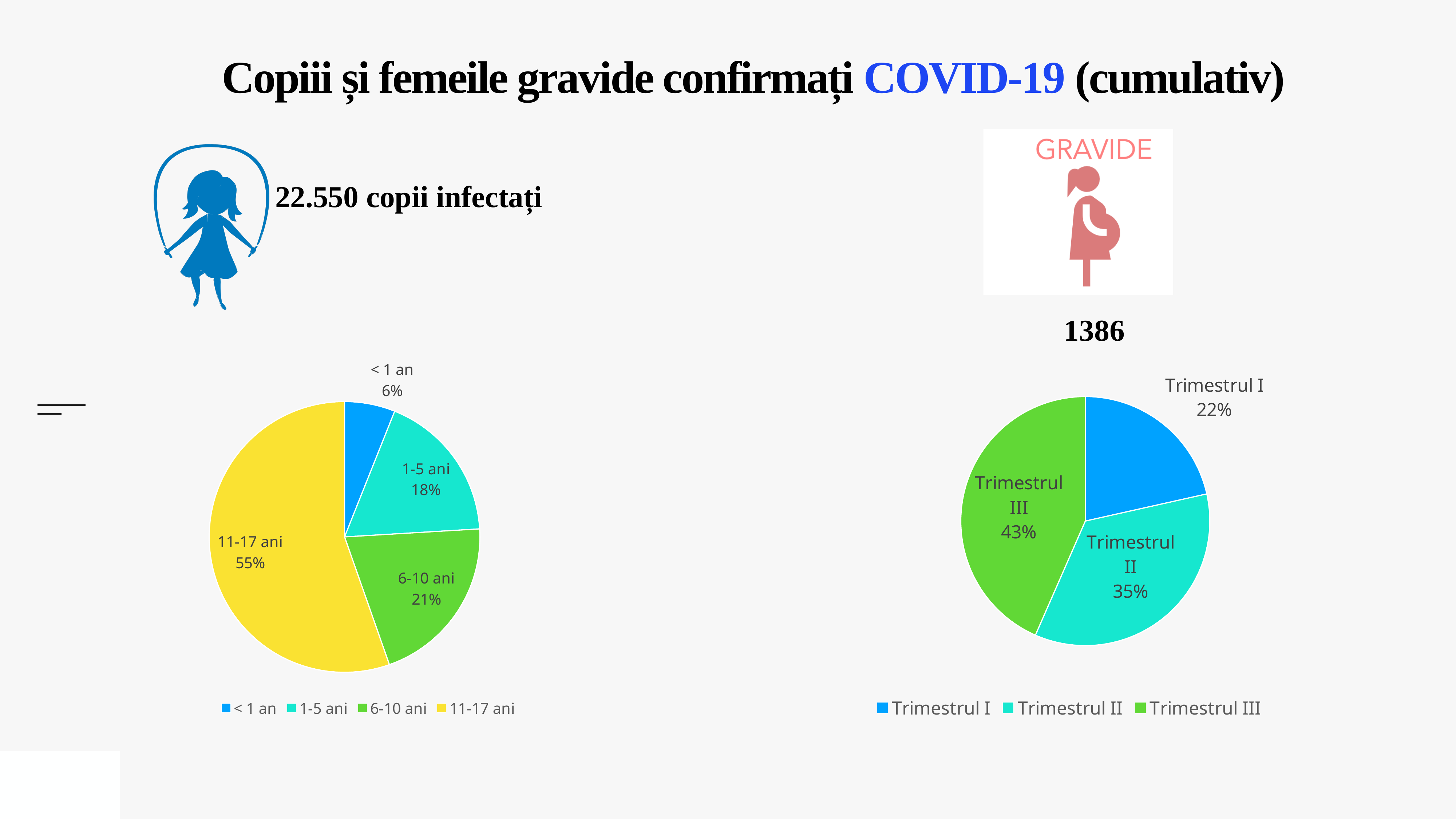
In the left pie chart (children by age group), which age group has the smallest slice? < 1 an In the left pie chart (children by age group), how many slices are there? 4 In the left pie chart (children by age group), what is the difference between the shares for 6-10 ani and 1-5 ani? 3% In the right pie chart (pregnant women by trimester), what share is labelled for Trimestrul II? 35% In the right pie chart (pregnant women by trimester), which is larger, Trimestrul I or Trimestrul II? Trimestrul II What kind of chart is the right chart (pregnant women by trimester)? Pie chart In the left pie chart (children by age group), what share is labelled for 11-17 ani? 55% In the left pie chart (children by age group), which age group has the largest slice? 11-17 ani In the right pie chart (pregnant women by trimester), what is the difference between the shares for Trimestrul III and Trimestrul I? 21% How many entries does the legend of the right pie chart (pregnant women by trimester) list? 3 In the right pie chart (pregnant women by trimester), which trimester has the largest slice? Trimestrul III In the left pie chart (children by age group), what share is labelled for < 1 an? 6%